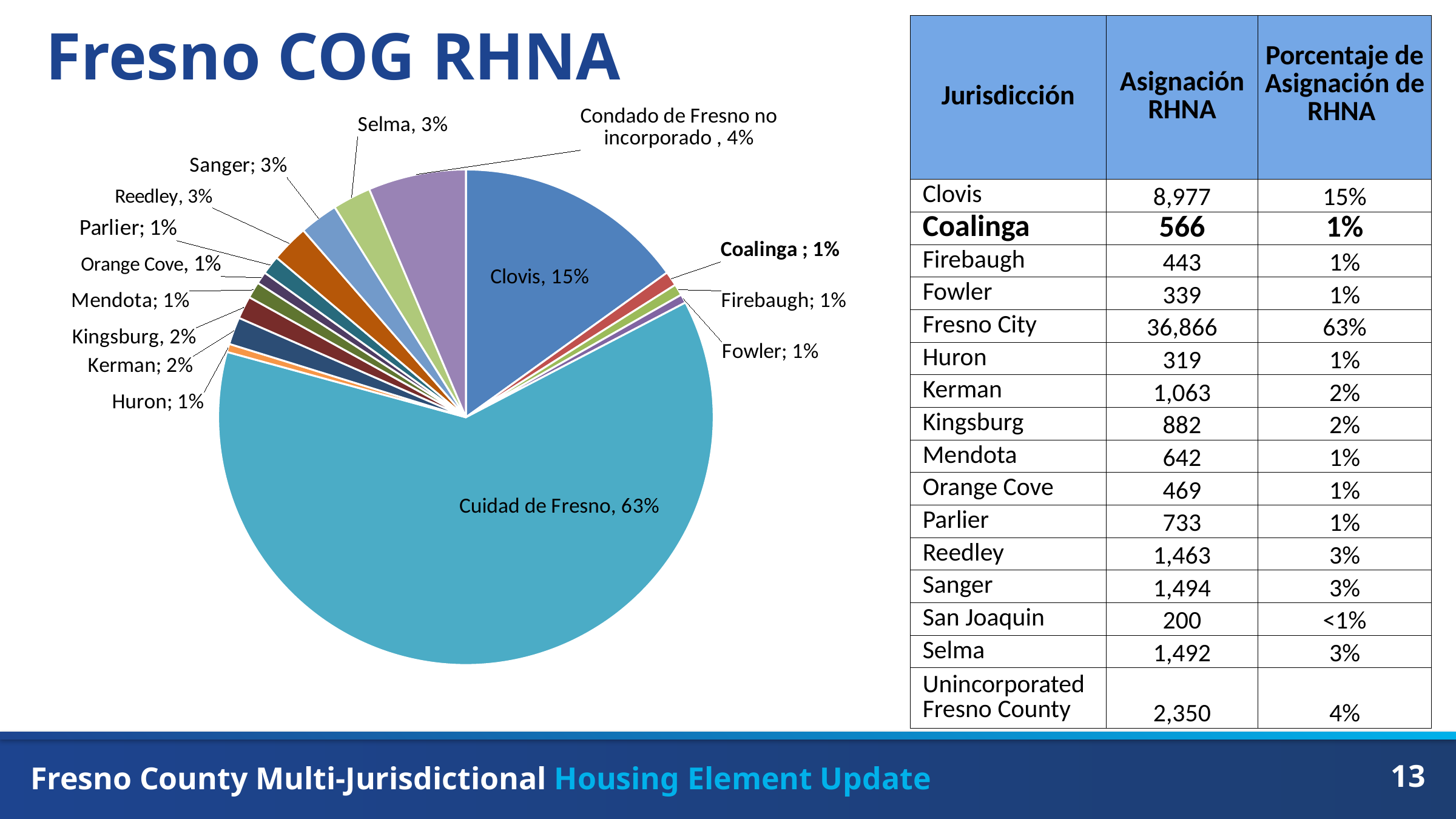
What share of the pie does Cuidad de Fresno hold? 63% What percentage is shown for Coalinga in the pie chart? 1% What percentage is shown for Kerman in the pie chart? 2% What percentage is shown for Condado de Fresno no incorporado in the pie chart? 4% Which slice label in the pie chart is shown in bold text? Coalinga ; 1% What percentage is shown for Clovis in the pie chart? 15% What percentage is shown for Selma in the pie chart? 3% Which slice of the pie chart is the largest? Cuidad de Fresno What kind of chart is shown on the slide? pie chart Which is larger in the pie chart, Condado de Fresno no incorporado or Kingsburg? Condado de Fresno no incorporado By how many percentage points does Clovis exceed Condado de Fresno no incorporado in the pie chart? 11 Which is larger in the pie chart, Clovis or Sanger? Clovis